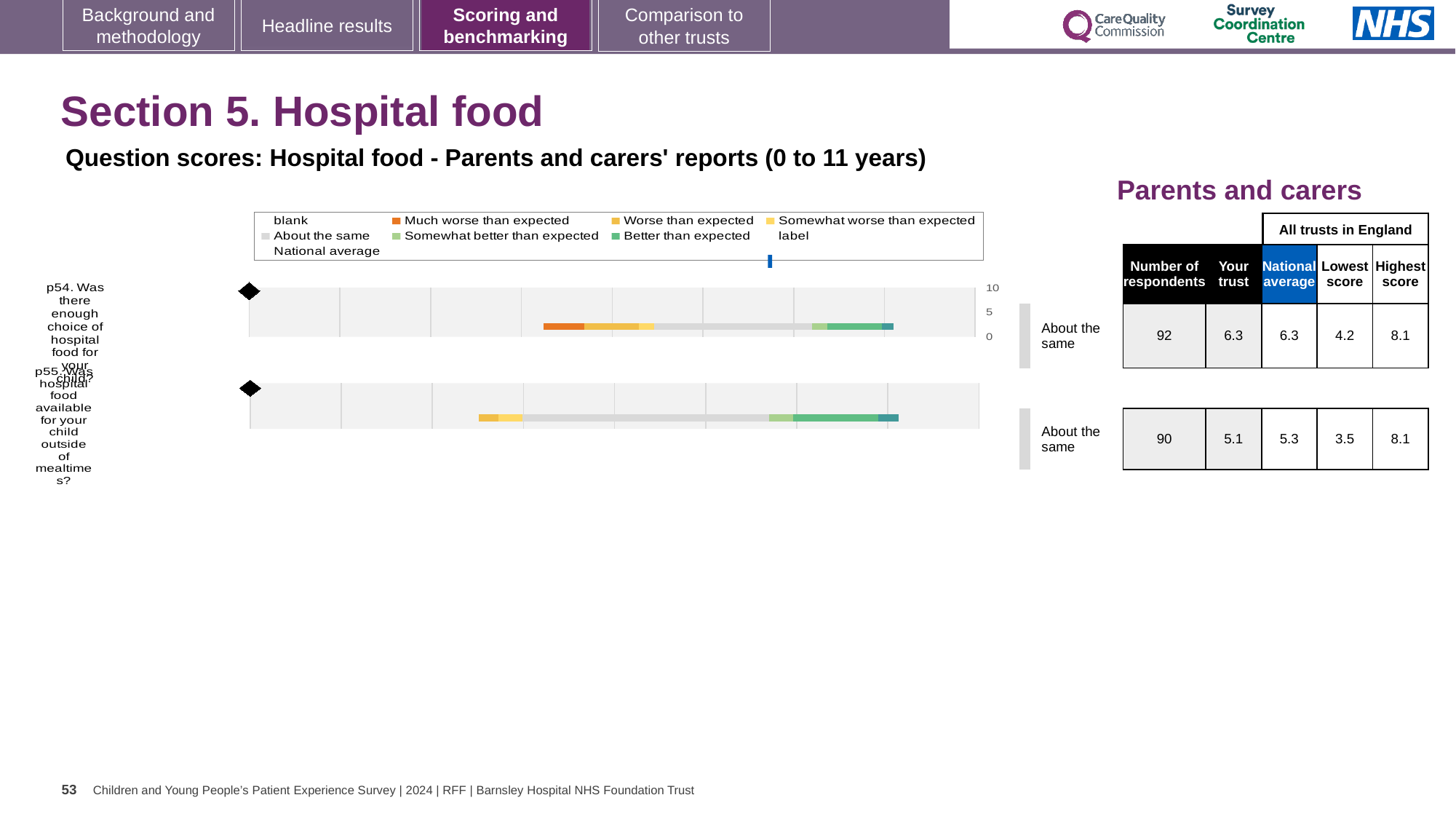
What is the lowest score across all trusts in England for p54? 4.2 Is the trust score for p54 greater or less than 5 on the chart's axis? greater What is the national average for p55? 5.3 What is the 'Your trust' score for p54 (enough choice of hospital food)? 6.3 Which question has the higher 'Your trust' score, p54 or p55? p54 What is the 'Your trust' score for p55 (hospital food available outside of mealtimes)? 5.1 What is the highest score across all trusts in England for p55? 8.1 Which legend entry is shown in orange? Much worse than expected What is the difference between the national average and the trust score for p55? 0.2 How many respondents answered p54? 92 What kind of chart is shown on the slide? bar chart How many questions (categories) are plotted in the chart? 2